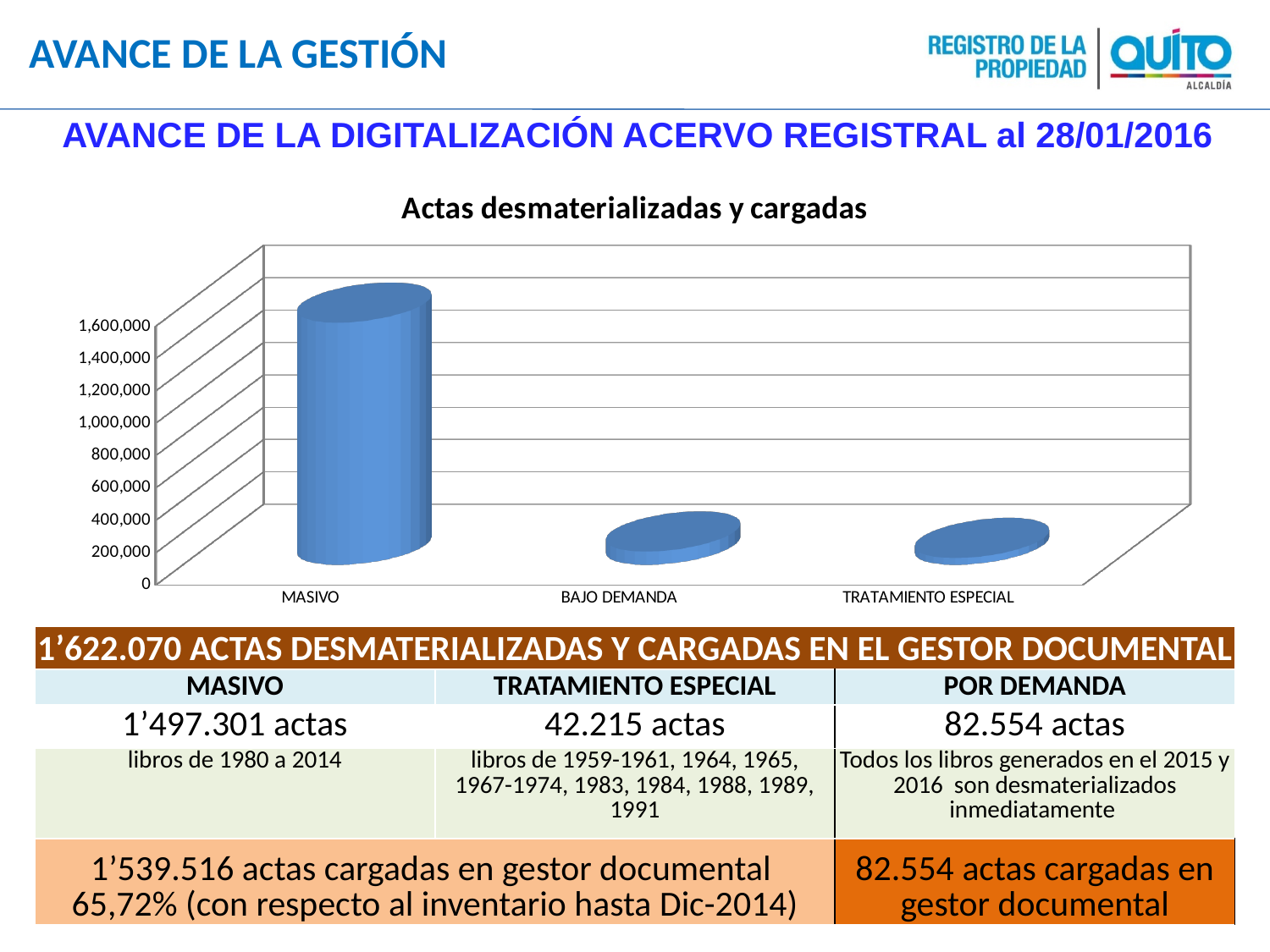
Which is larger, the value for MASIVO or the value for TRATAMIENTO ESPECIAL? MASIVO Is the value for BAJO DEMANDA greater or less than 200,000? less Is the value for MASIVO greater or less than 1,000,000? greater What is the title of the chart? Actas desmaterializadas y cargadas What kind of chart is shown on the slide? bar chart Is the value for MASIVO greater or less than 1,400,000? greater Which category has the highest value in the chart? MASIVO Which is larger, the value for MASIVO or the value for BAJO DEMANDA? MASIVO What is the highest tick value shown on the vertical axis of the chart? 1,600,000 How many categories are shown on the x axis of the chart? 3